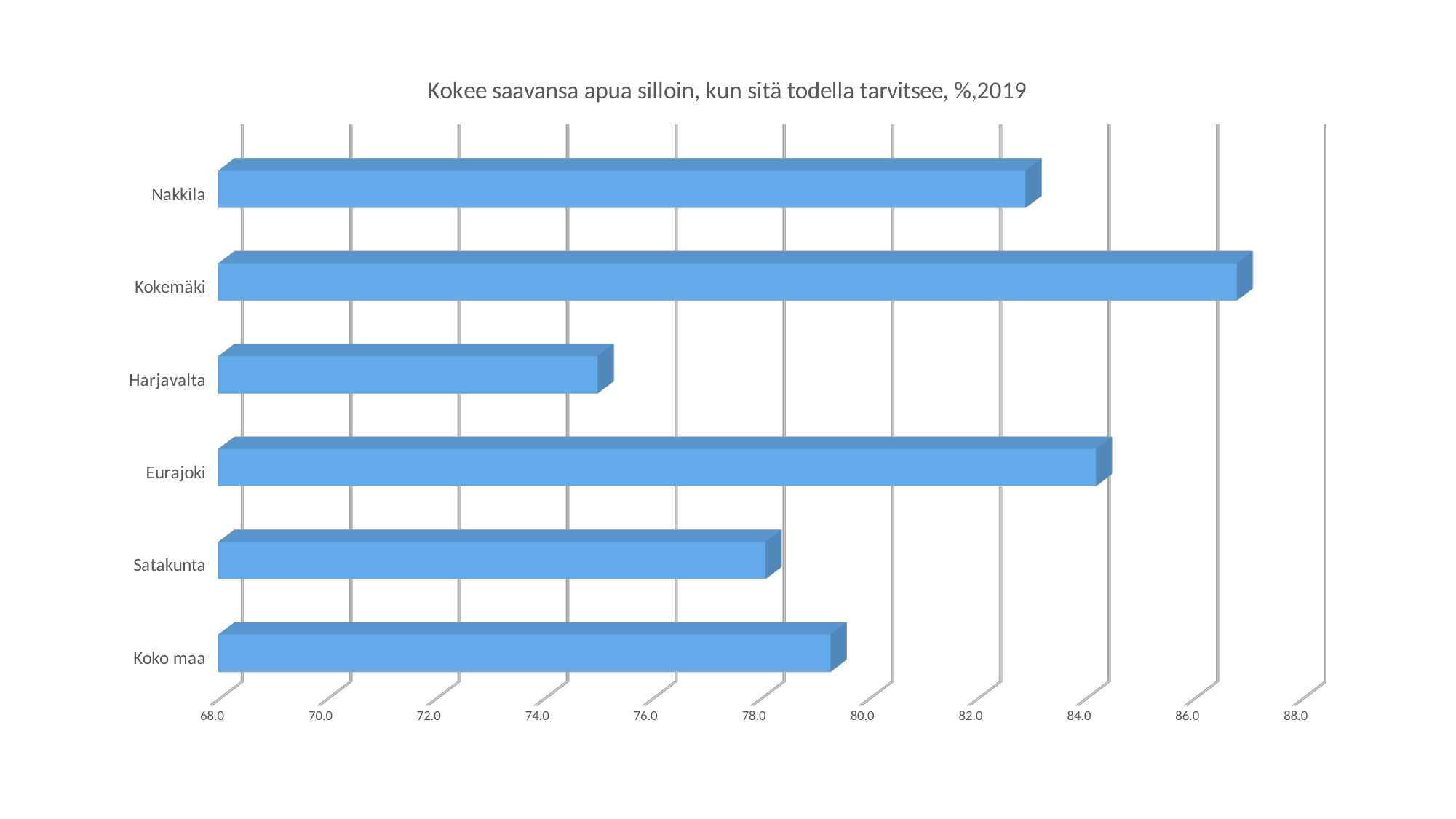
Which category has the lowest value? Harjavalta Is the value for Eurajoki greater or less than 86.0? less Is the value for Satakunta greater or less than 80.0? less What kind of chart is shown on the slide? bar chart Is the value for Koko maa greater or less than 78.0? greater What is the title of the chart? Kokee saavansa apua silloin, kun sitä todella tarvitsee, %,2019 How many categories are plotted in the chart? 6 Which category has the highest value? Kokemäki Which has the larger value, Nakkila or Eurajoki? Eurajoki